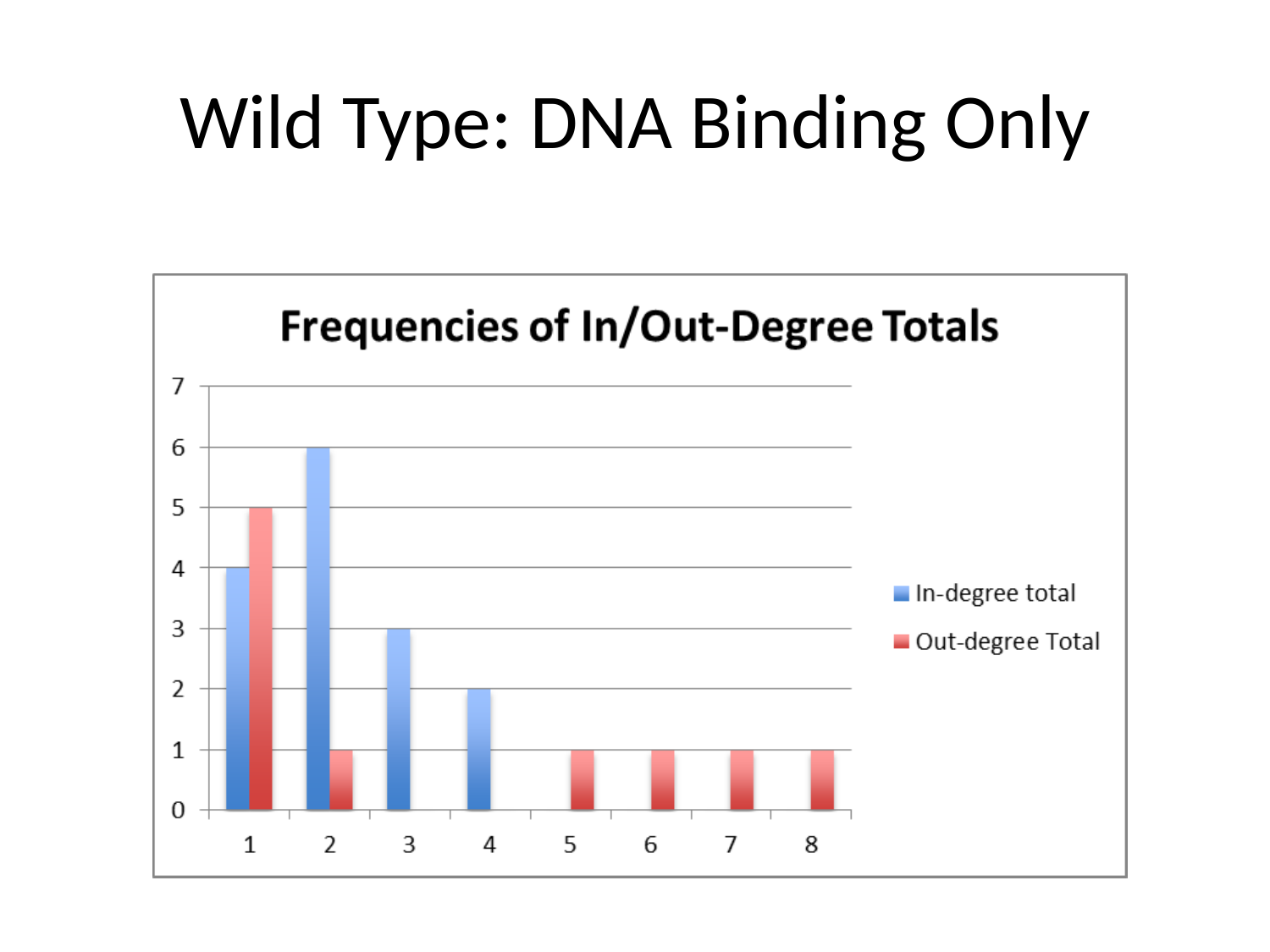
Does the In-degree total fall or rise from category 2 to category 4? Fall What is the In-degree total value for category 4? 2 Which category has the highest In-degree total? 2 What type of chart is shown on the slide? Bar chart How many series does the legend list? 2 What is the title of the chart? Frequencies of In/Out-Degree Totals What is the Out-degree Total value for category 1? 5 What is the In-degree total value for category 2? 6 How many categories are shown on the x axis? 8 For category 1, which is larger: the In-degree total or the Out-degree Total? Out-degree Total Which category has the highest Out-degree Total? 1 What is the difference between the In-degree total and the Out-degree Total for category 2? 5